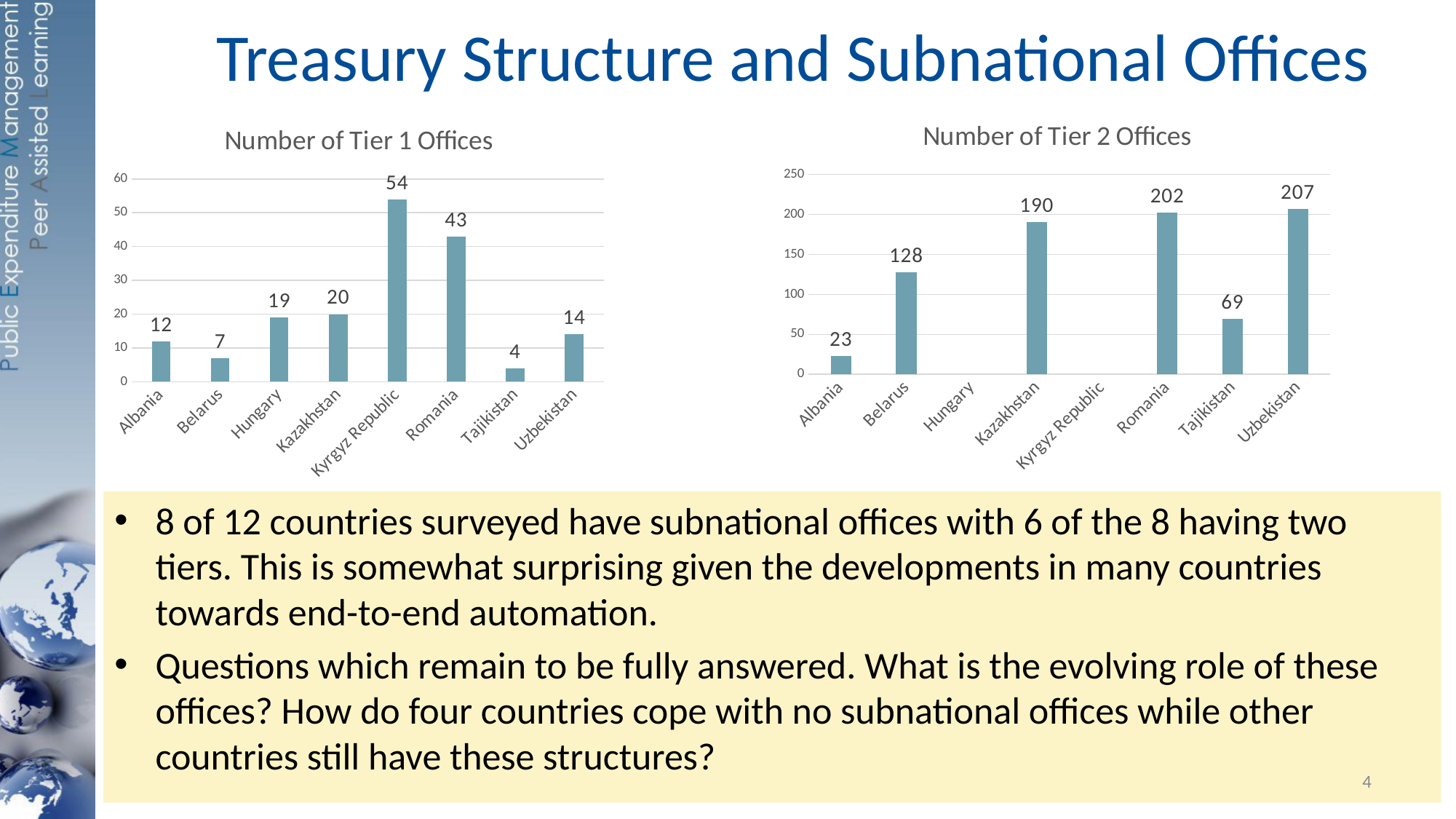
In the 'Number of Tier 2 Offices' chart, how many Tier 2 offices does Belarus have? 128 In the 'Number of Tier 1 Offices' chart, which country has the lowest value? Tajikistan In the 'Number of Tier 1 Offices' chart, how many Tier 1 offices does the Kyrgyz Republic have? 54 In the 'Number of Tier 2 Offices' chart, is the value for Albania greater or less than 50? less What kind of chart is the 'Number of Tier 2 Offices' chart? Bar chart In the 'Number of Tier 2 Offices' chart, which country has the highest value? Uzbekistan In the 'Number of Tier 1 Offices' chart, how many countries are shown on the x axis? 8 In the 'Number of Tier 1 Offices' chart, which country has the highest value? Kyrgyz Republic In the 'Number of Tier 1 Offices' chart, what is the difference between Romania and Albania? 31 In the 'Number of Tier 2 Offices' chart, which two countries have no bar shown? Hungary and Kyrgyz Republic In the 'Number of Tier 2 Offices' chart, what is the difference between Uzbekistan and Romania? 5 In the 'Number of Tier 2 Offices' chart, which is larger, the value for Kazakhstan or the value for Tajikistan? Kazakhstan